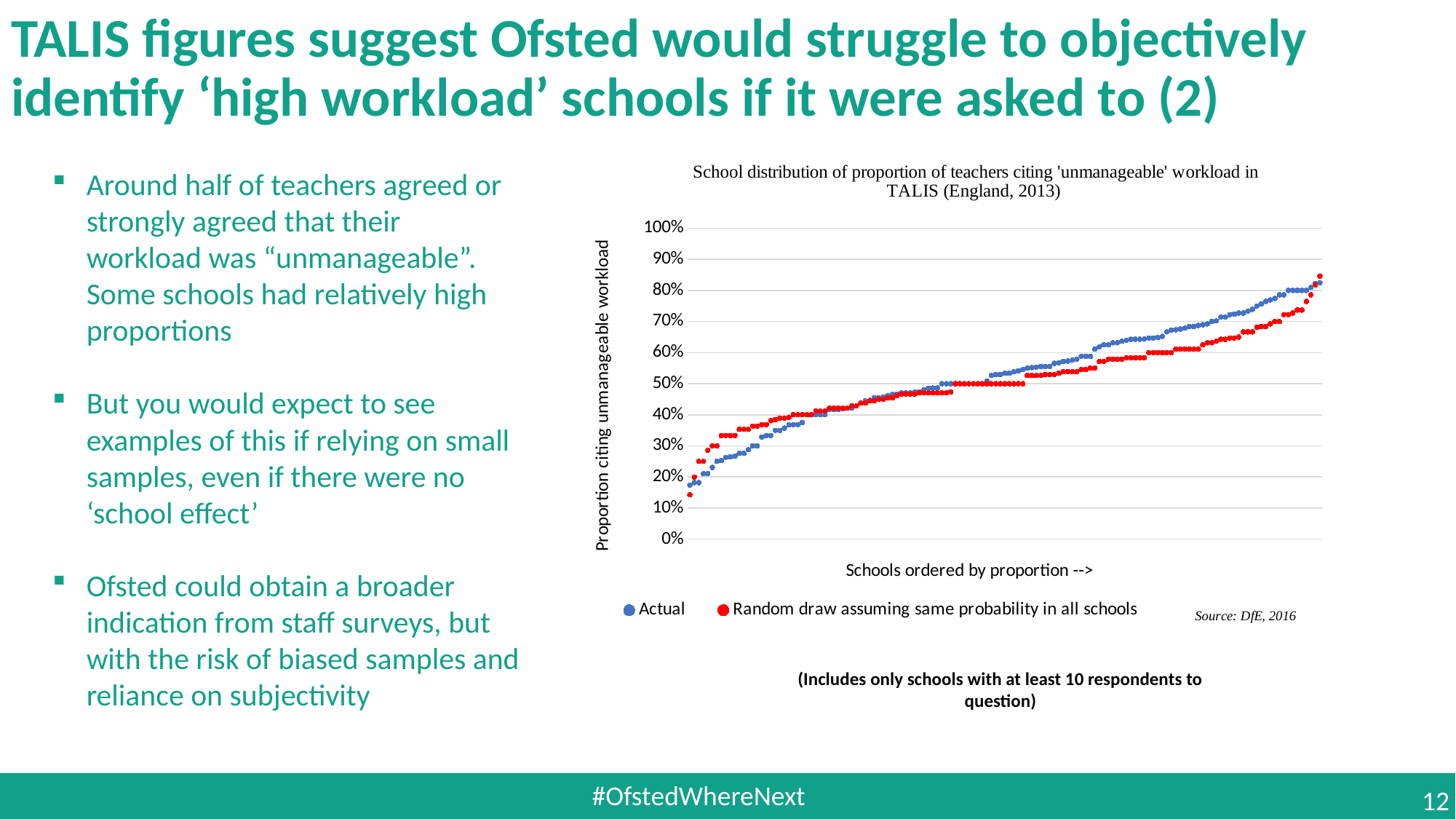
Is the lowest value in the Random draw series greater or less than 20%? less Is the highest value in the Random draw series greater or less than 80%? greater What is the title of the chart? School distribution of proportion of teachers citing 'unmanageable' workload in TALIS (England, 2013) Which series is plotted in blue? Actual How many series does the chart's legend list? 2 Is the highest value in the Actual series greater or less than 90%? less What are the two series named in the chart's legend? Actual; Random draw assuming same probability in all schools Do the values of the Actual series rise or fall moving left to right along the x axis? Rise What kind of chart is shown on the slide? Scatter chart